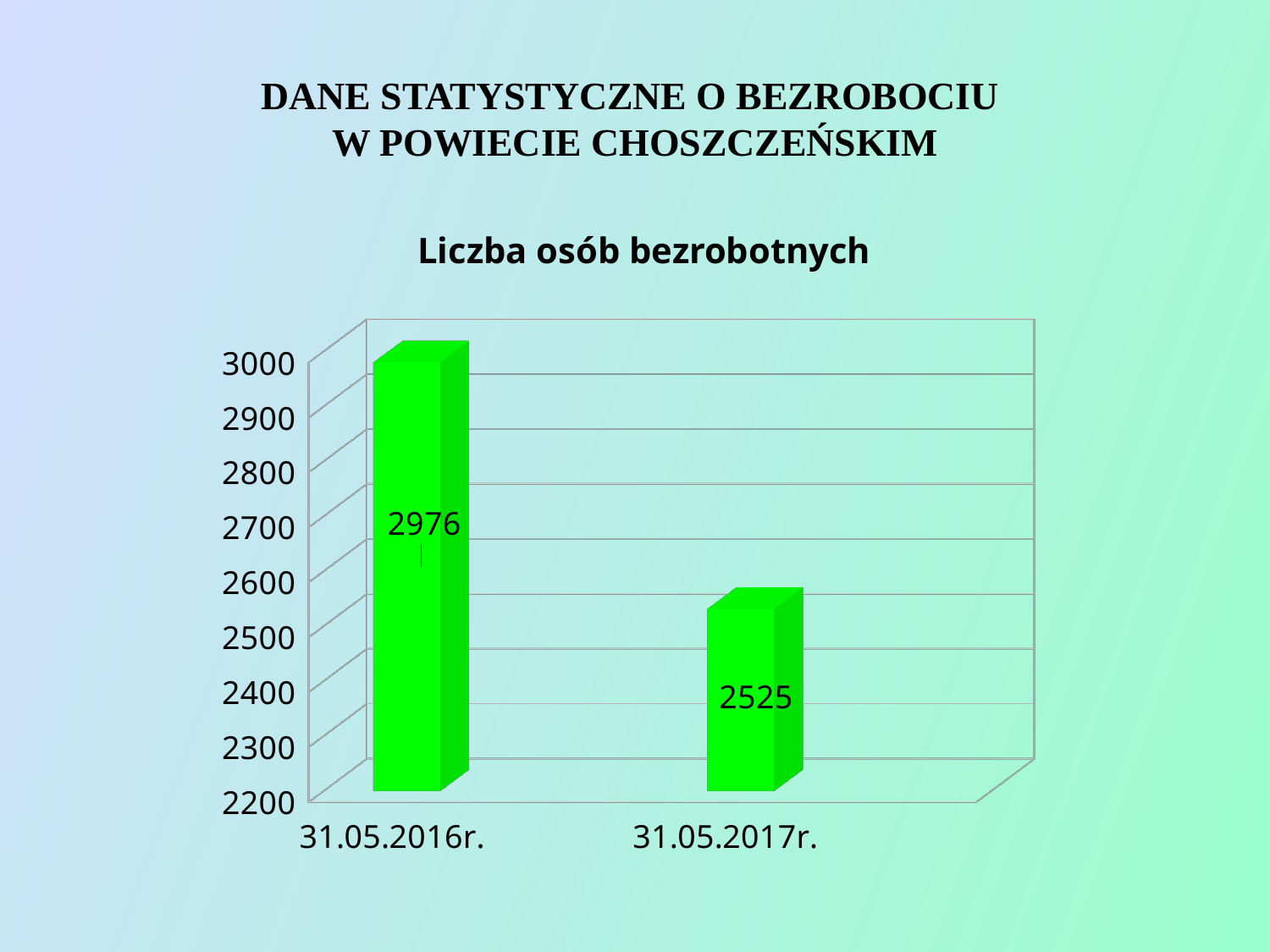
Which date has the lower number of unemployed persons? 31.05.2017r. Do the values rise or fall from 31.05.2016r. to 31.05.2017r.? fall What is the number of unemployed persons shown for 31.05.2016r.? 2976 How many categories (dates) are shown on the chart? 2 What is the number of unemployed persons shown for 31.05.2017r.? 2525 Which date has the higher number of unemployed persons? 31.05.2016r. What kind of chart is shown on the slide? bar chart Is the value for 31.05.2017r. greater or less than 2600? less Is the value for 31.05.2016r. larger or smaller than the value for 31.05.2017r.? larger What is the title of the chart? Liczba osób bezrobotnych Is the value for 31.05.2016r. greater or less than 2900? greater What is the difference between the values for 31.05.2016r. and 31.05.2017r.? 451